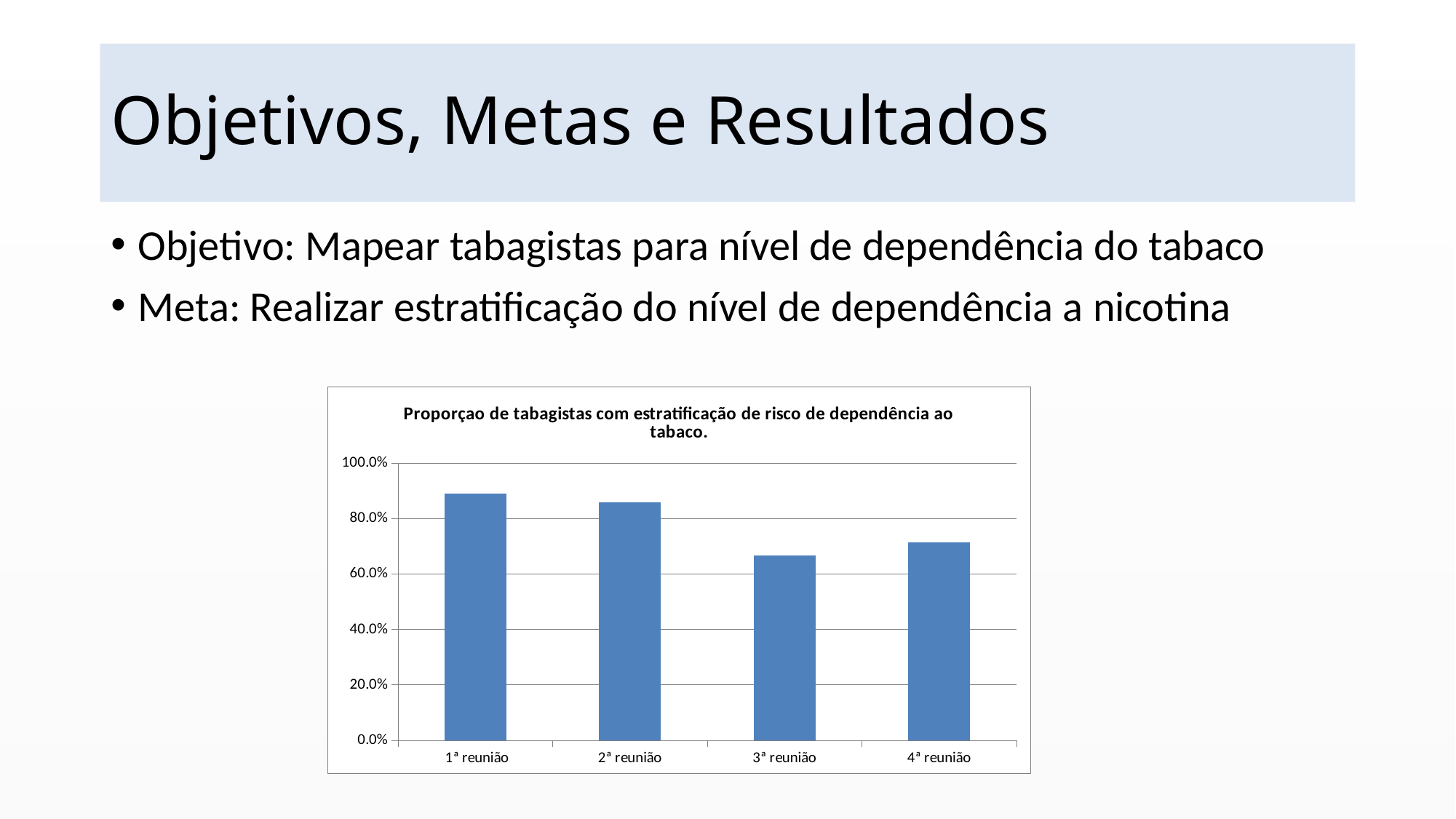
How many categories (reuniões) are shown on the x axis of the chart? 4 Is the value for 3ª reunião greater or less than 80.0%? less What is the title of the chart? Proporçao de tabagistas com estratificação de risco de dependência ao tabaco. Is the value for 1ª reunião greater or less than 80.0%? greater Which reunião has the highest proportion in the chart? 1ª reunião What kind of chart is shown on the slide? bar chart Do the values rise or fall from 1ª reunião to 3ª reunião? fall Is the value for 4ª reunião greater or less than 60.0%? greater Which has a larger value, 1ª reunião or 3ª reunião? 1ª reunião Which has a larger value, 2ª reunião or 4ª reunião? 2ª reunião Which reunião has the lowest proportion in the chart? 3ª reunião